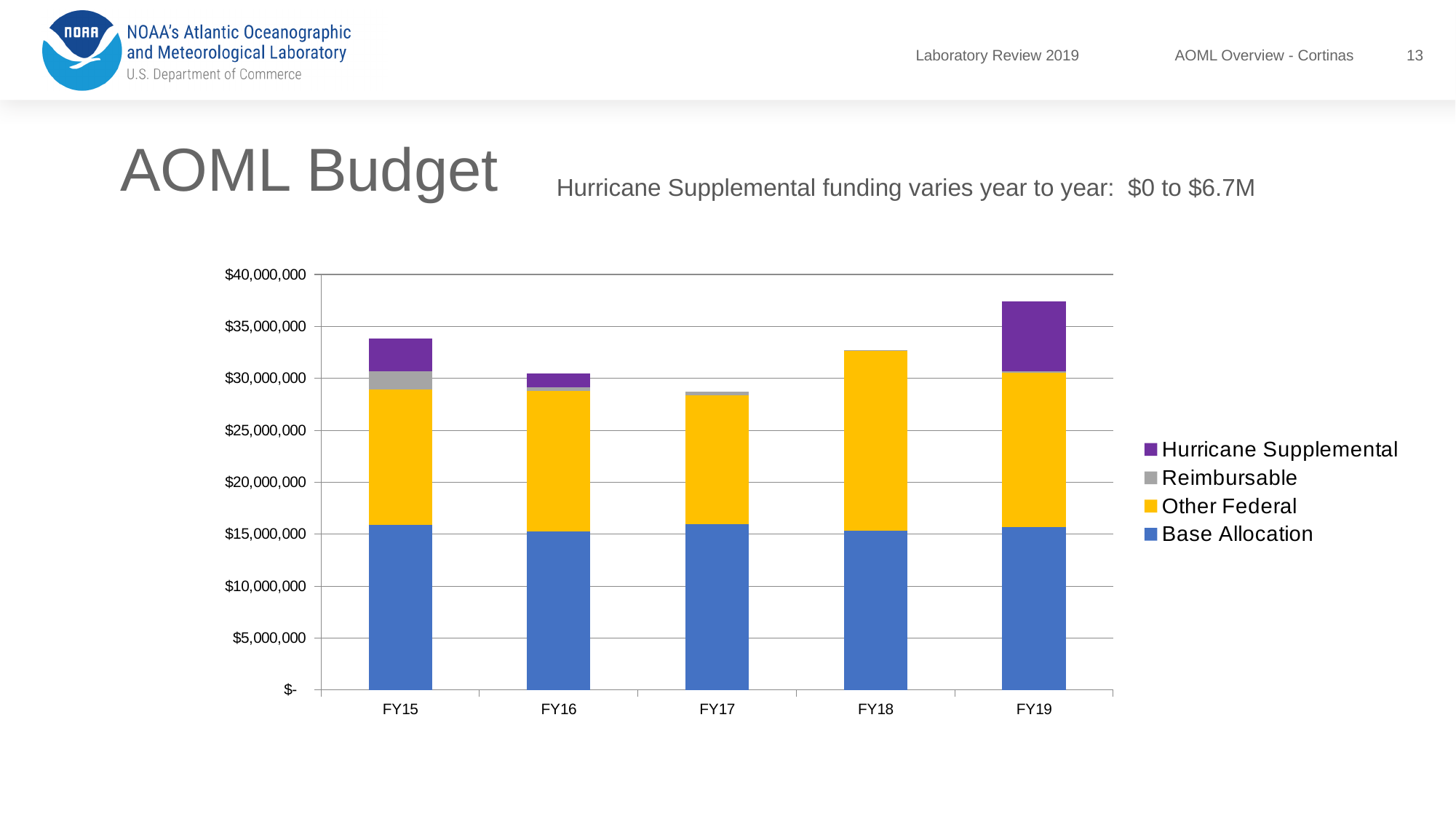
Which fiscal year has the lowest total budget bar? FY17 What colour represents Hurricane Supplemental in the chart's legend? Purple Is the total bar for FY17 greater or less than $30,000,000? less Which fiscal year has the largest Hurricane Supplemental segment? FY19 Which fiscal year has the highest total budget bar? FY19 What kind of chart is shown on the slide? Stacked bar chart How many fiscal years are shown on the x axis of the chart? 5 Is the Base Allocation for FY16 greater or less than $20,000,000? less Which is larger, the total bar for FY15 or the total bar for FY16? FY15 Is the total bar for FY18 greater or less than $30,000,000? greater How many series does the chart's legend list? 4